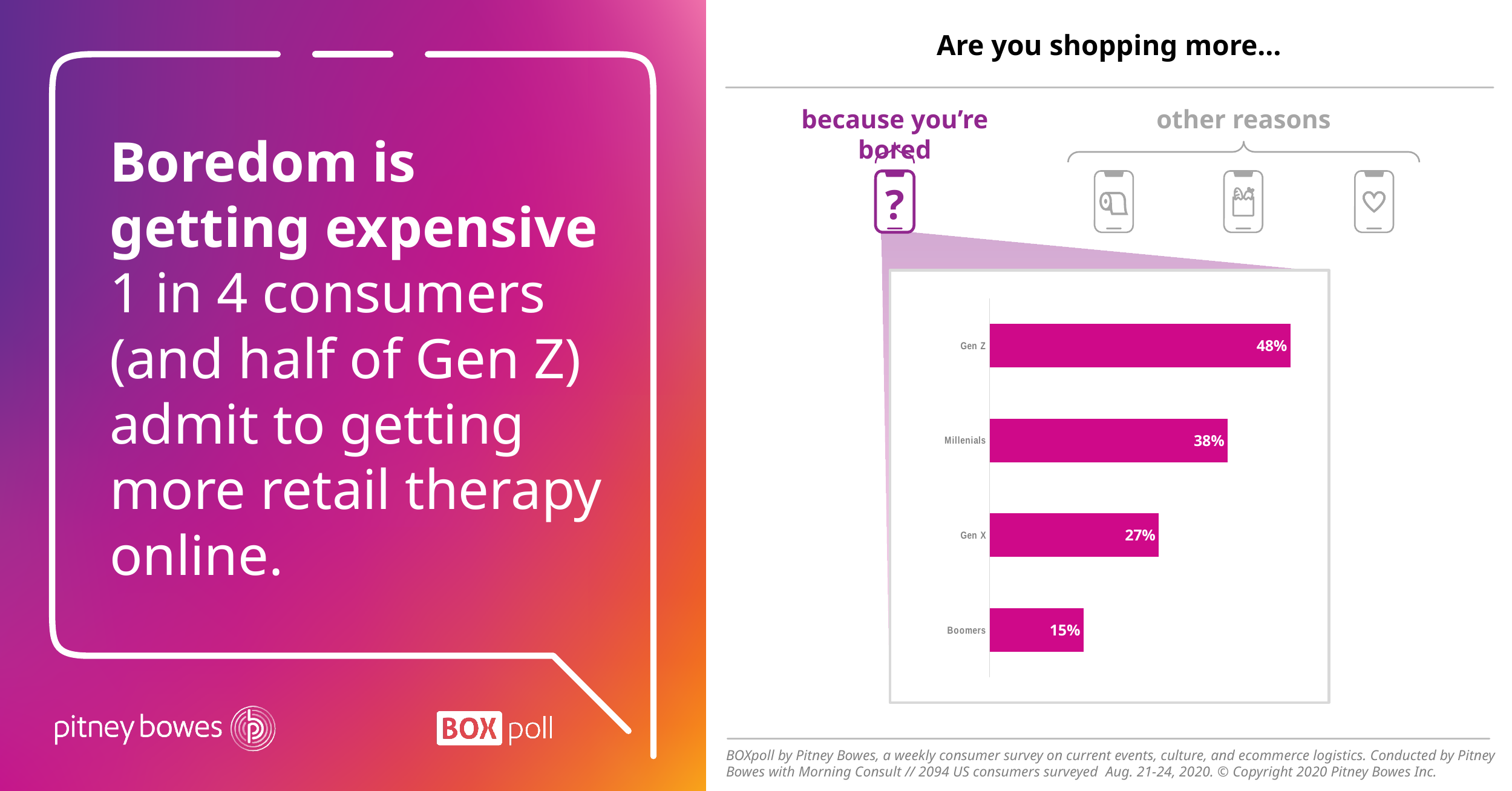
What is the title of the chart section on the right side of the slide? Are you shopping more... Which generation has the lowest value in the bar chart? Boomers What is the value shown for Millenials in the bar chart? 38% How many generation categories are shown in the bar chart? 4 Which generation has the highest value in the bar chart? Gen Z What percentage of Gen Z say they are shopping more because they're bored? 48% What is the value shown for Boomers in the bar chart? 15% What type of chart is used to show the values by generation? Bar chart What is the difference between the Gen Z and Boomers values? 33% What is the difference between the Millenials and Gen X values? 11% Which has a larger value, Gen X or Millenials? Millenials What is the value shown for Gen X in the bar chart? 27%